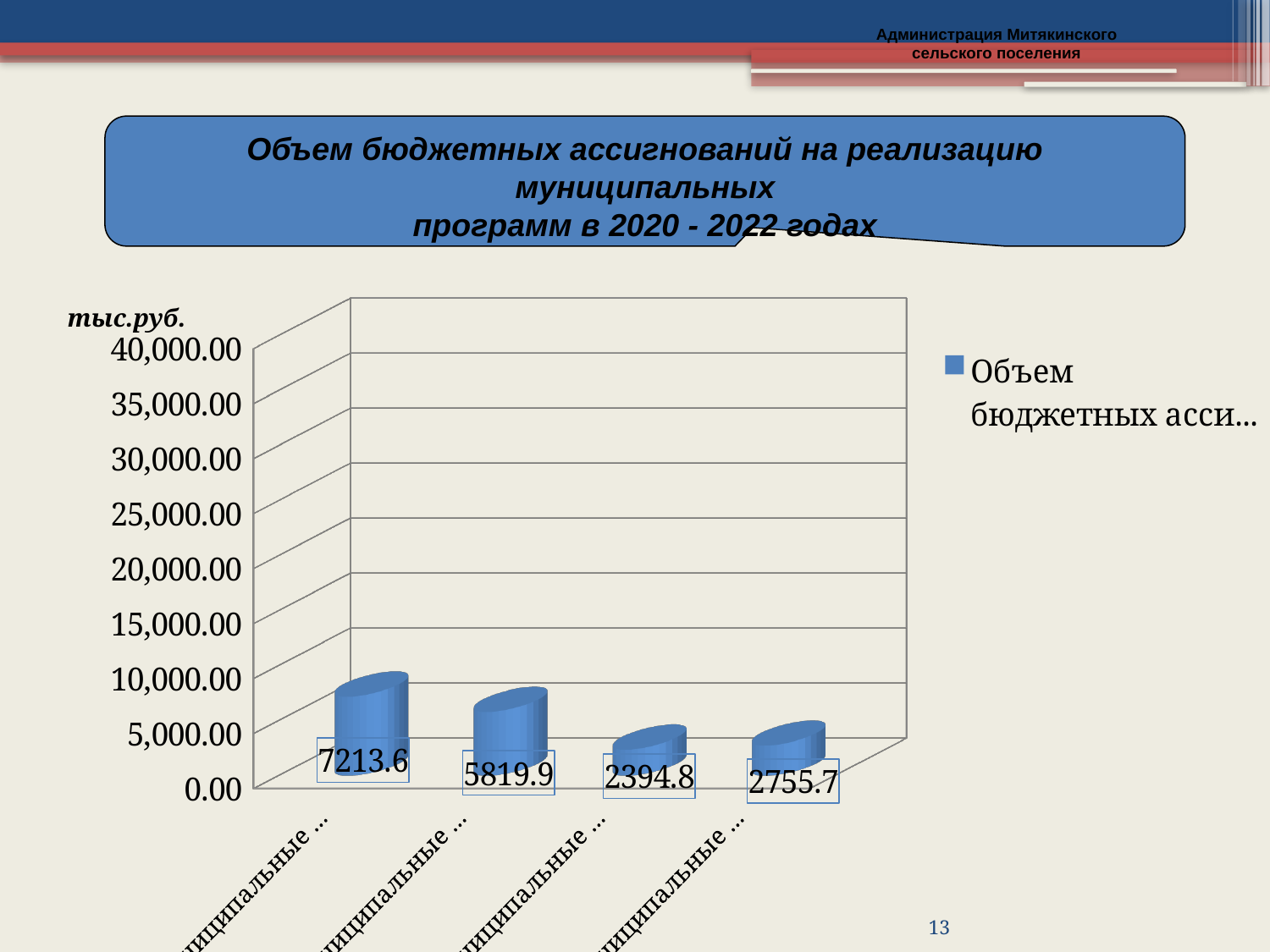
Which bar has the highest value? The first (leftmost) bar, 7213.6 What is the value shown on the first (leftmost) bar of the chart? 7213.6 How many bars are plotted in the chart? 4 What is the value shown on the fourth (rightmost) bar? 2755.7 Is the value of the first bar greater or less than 10,000.00? less What is the difference between the values of the first and second bars? 1393.7 What is the value shown on the second bar from the left? 5819.9 What type of chart is shown on the slide? Bar chart Which bar has the lowest value? The third bar from the left, 2394.8 Which is larger, the value of the third bar or the fourth bar? The fourth bar (2755.7) What is the value shown on the third bar from the left? 2394.8 What unit is indicated above the vertical axis of the chart? тыс.руб.